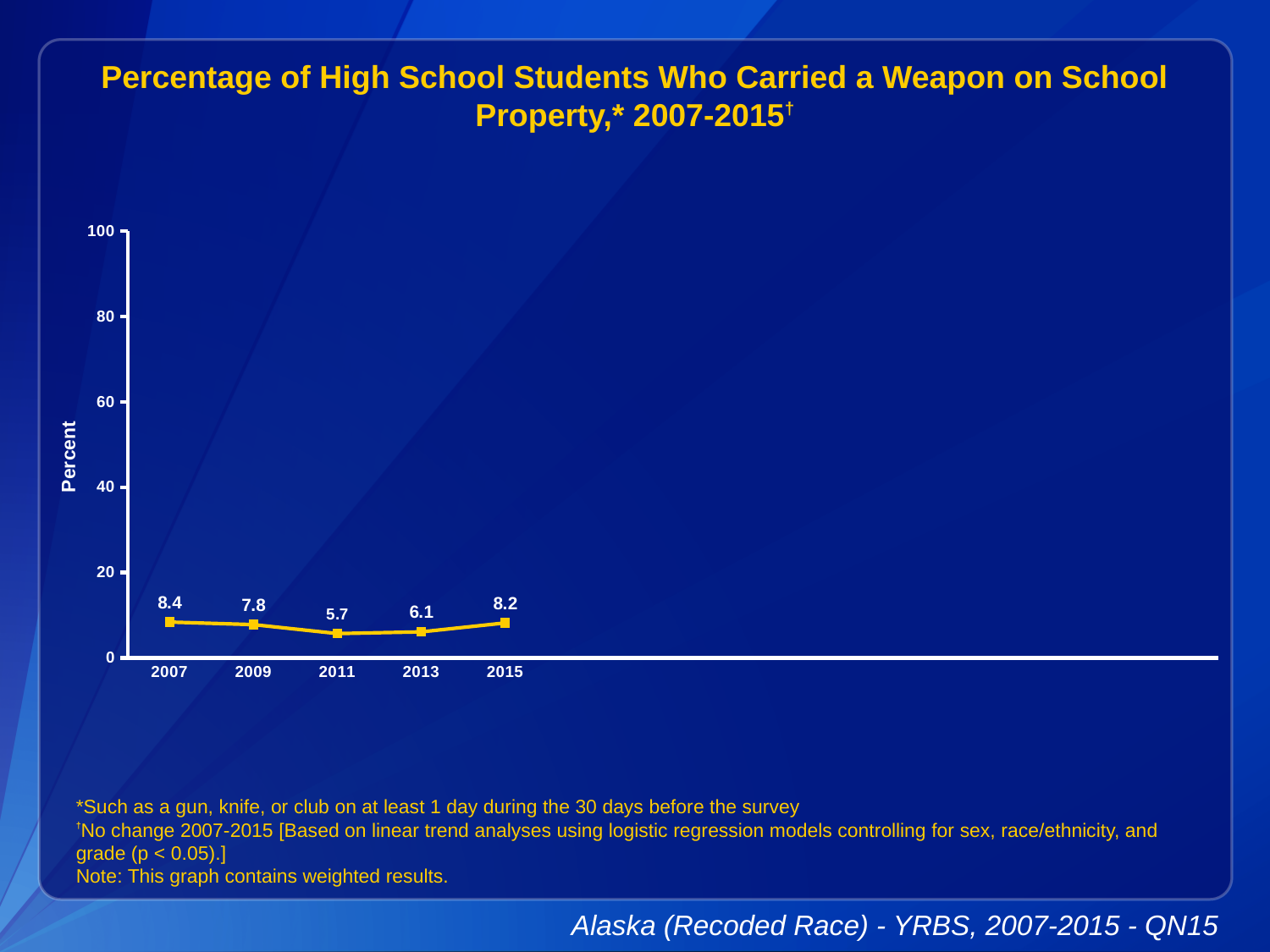
What is the value plotted for 2011? 5.7 Is the value for 2013 greater or less than 20? less Does the value rise or fall from 2011 to 2015? rise What is the label on the y axis? Percent What kind of chart is shown on the slide? line chart What is the difference between the 2007 value and the 2011 value? 2.7 Which year has the lowest value on the chart? 2011 Which year has the larger value, 2009 or 2013? 2009 What is the value plotted for 2015? 8.2 How many years are plotted on the x axis? 5 What percentage of high school students carried a weapon on school property in 2007? 8.4 Which year has the highest value on the chart? 2007